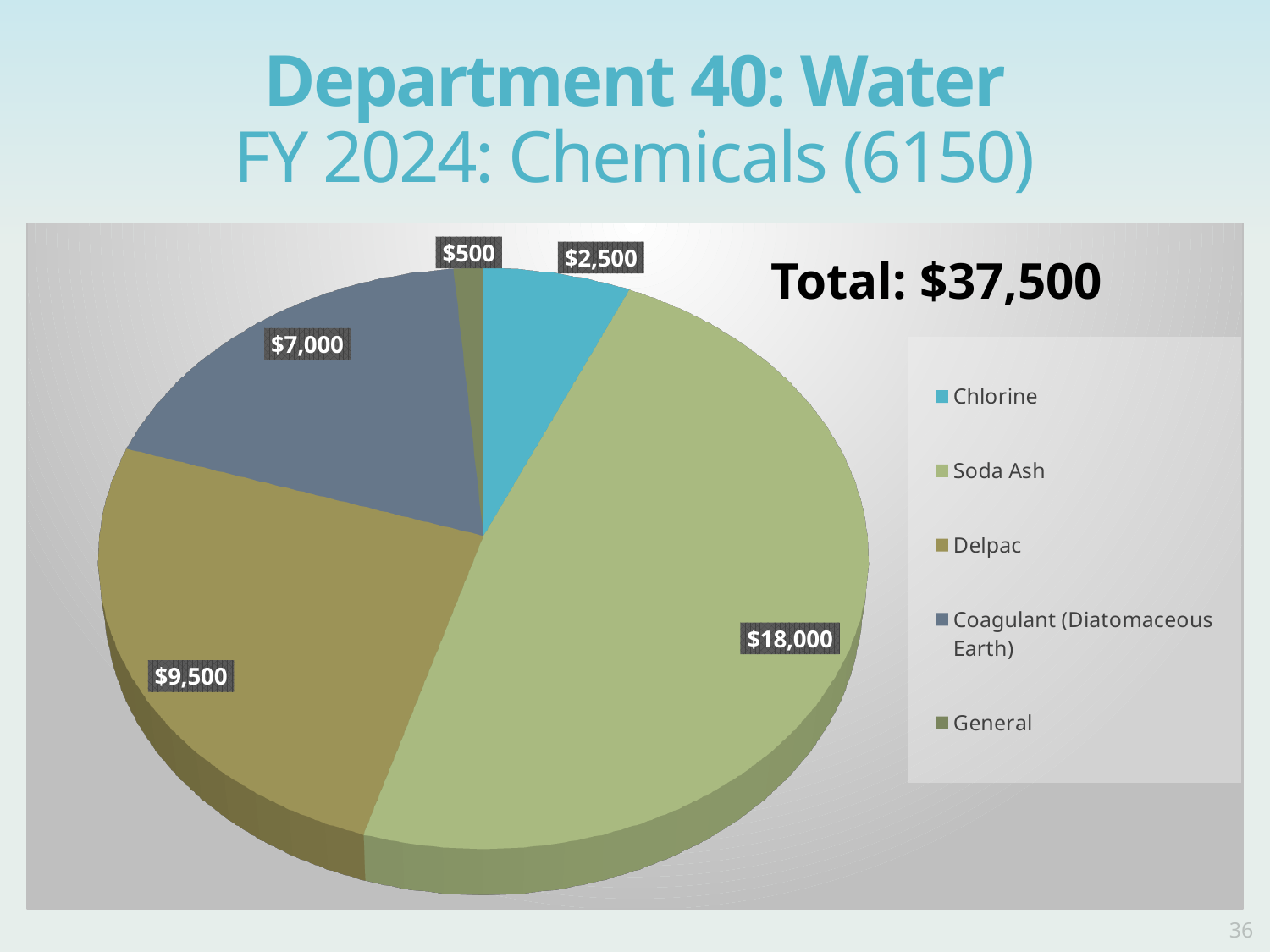
Which is larger, the value for Coagulant (Diatomaceous Earth) or the value for Chlorine? Coagulant (Diatomaceous Earth) What is the value for Soda Ash? $18,000 Which category has the largest slice of the pie? Soda Ash Which category has the smallest slice of the pie? General What is the value for General? $500 How many categories does the pie chart show? 5 What type of chart is shown on the slide? Pie chart What is the value for Coagulant (Diatomaceous Earth)? $7,000 What is the difference between the values for Soda Ash and Delpac? $8,500 What is the value for Chlorine? $2,500 What is the value for Delpac? $9,500 What share of the total does Soda Ash represent? 48%